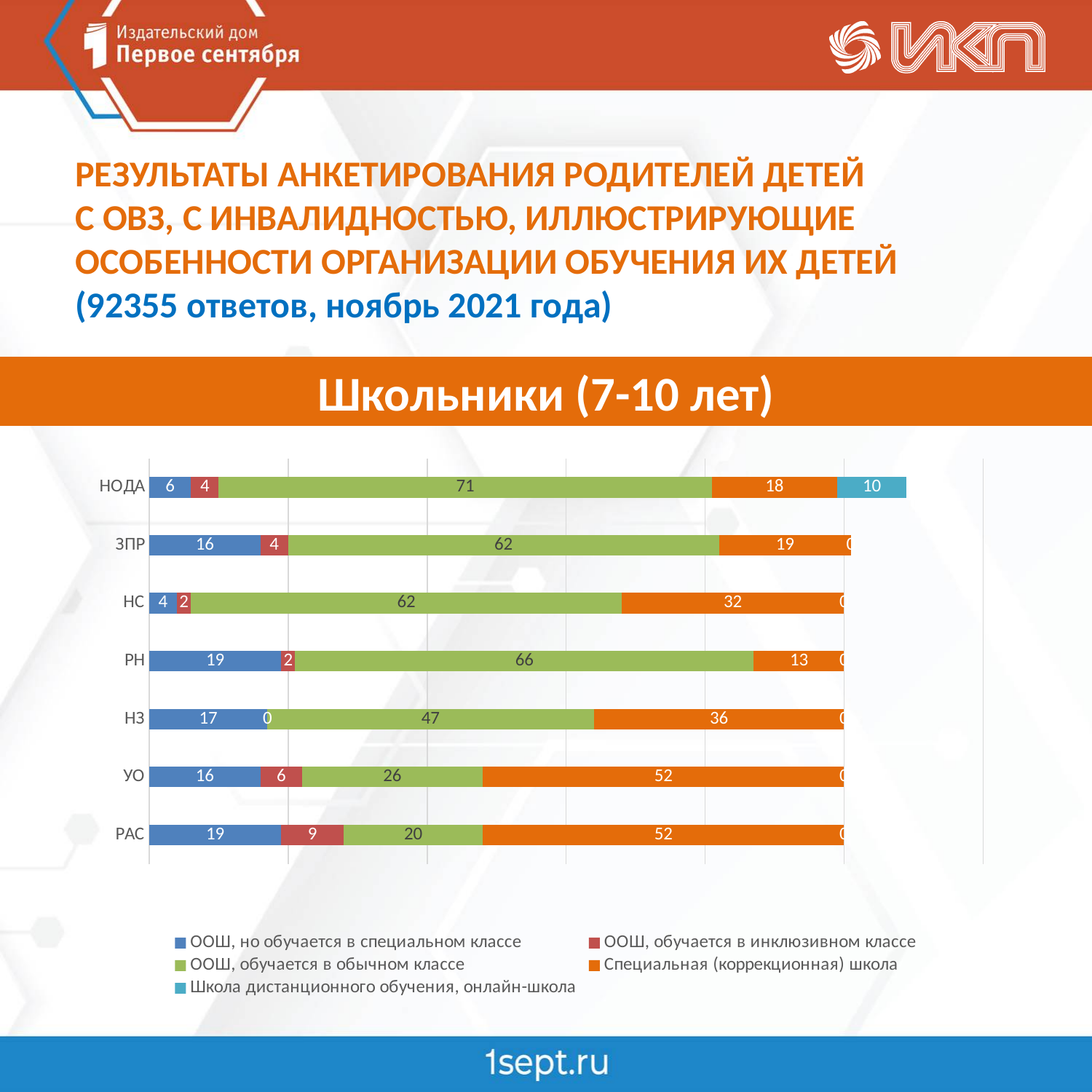
What is the value for НОДА in the series "ООШ, обучается в обычном классе"? 71 What is the value for НОДА in the series "Школа дистанционного обучения, онлайн-школа"? 10 Which category has the highest value in the series "ООШ, обучается в обычном классе"? НОДА What is the value for НЗ in the series "ООШ, но обучается в специальном классе"? 17 How many categories are shown on the chart? 7 Which category has the lowest value in the series "Специальная (коррекционная) школа"? РН What is the value for РАС in the series "Специальная (коррекционная) школа"? 52 Which category has the lowest value in the series "ООШ, обучается в обычном классе"? РАС How many series does the legend list? 5 Which is larger in the series "ООШ, обучается в инклюзивном классе": РАС or УО? РАС What kind of chart is shown on the slide? Stacked bar chart What is the difference between НС and РН in the series "Специальная (коррекционная) школа"? 19